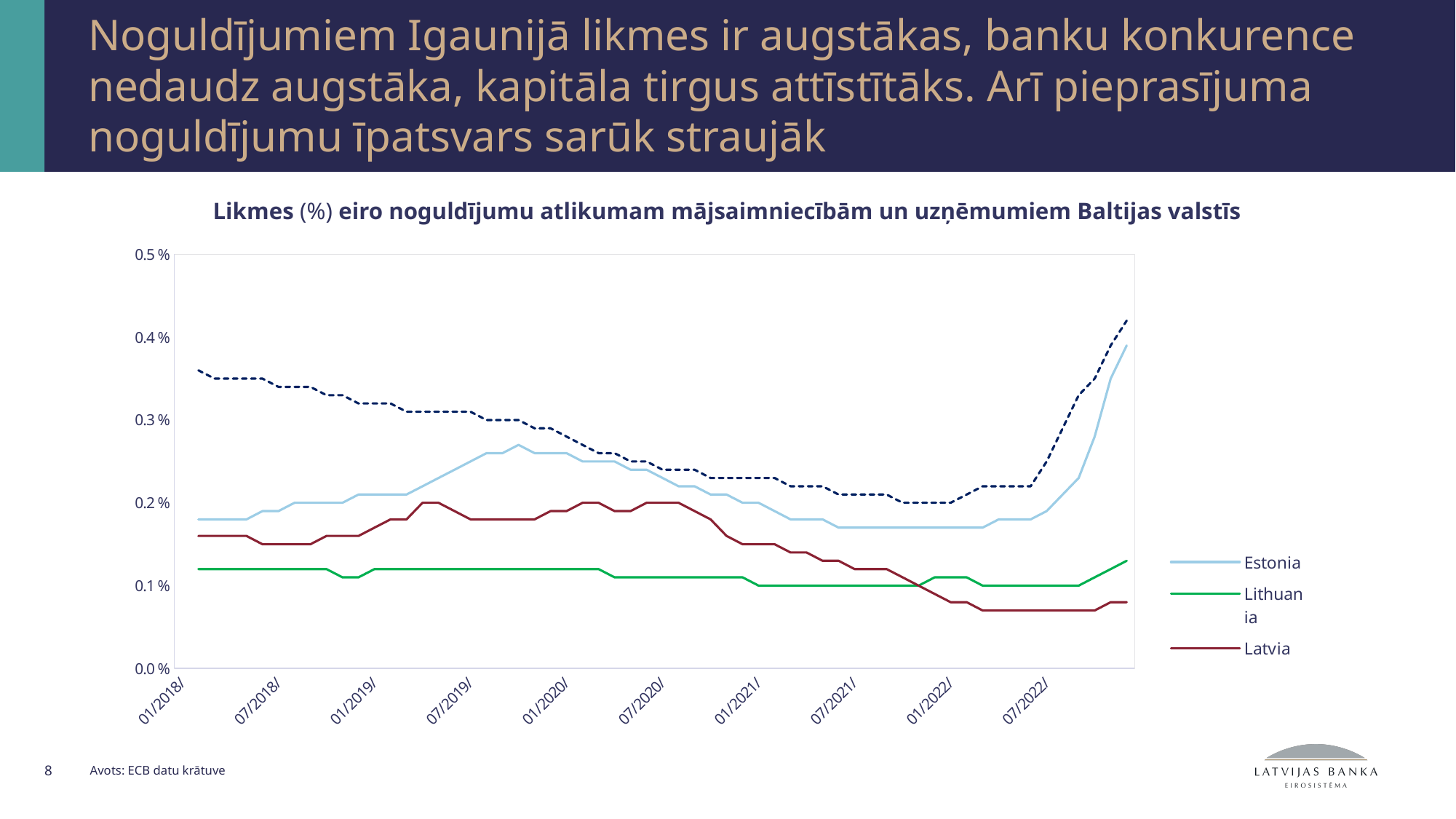
Does the Latvia line rise or fall overall from 01/2018 to the right end of the chart? fall How many series does the legend list? 3 Is the value for Lithuania at 01/2018 greater or less than 0.1 %? greater Which series in the legend has the highest value at the right end of the chart? Estonia Is the value for Estonia at the right end of the chart greater or less than 0.3 %? greater Is the value for Latvia at the right end of the chart greater or less than 0.1 %? less At 01/2018, which is larger, the value for Latvia or the value for Lithuania? Latvia What is the highest value shown on the y axis? 0.5 % What kind of chart is shown on the slide? line chart Does the Estonia line rise or fall from 01/2022 to the right end of the chart? rise Which series in the legend has the lowest value at the right end of the chart? Latvia